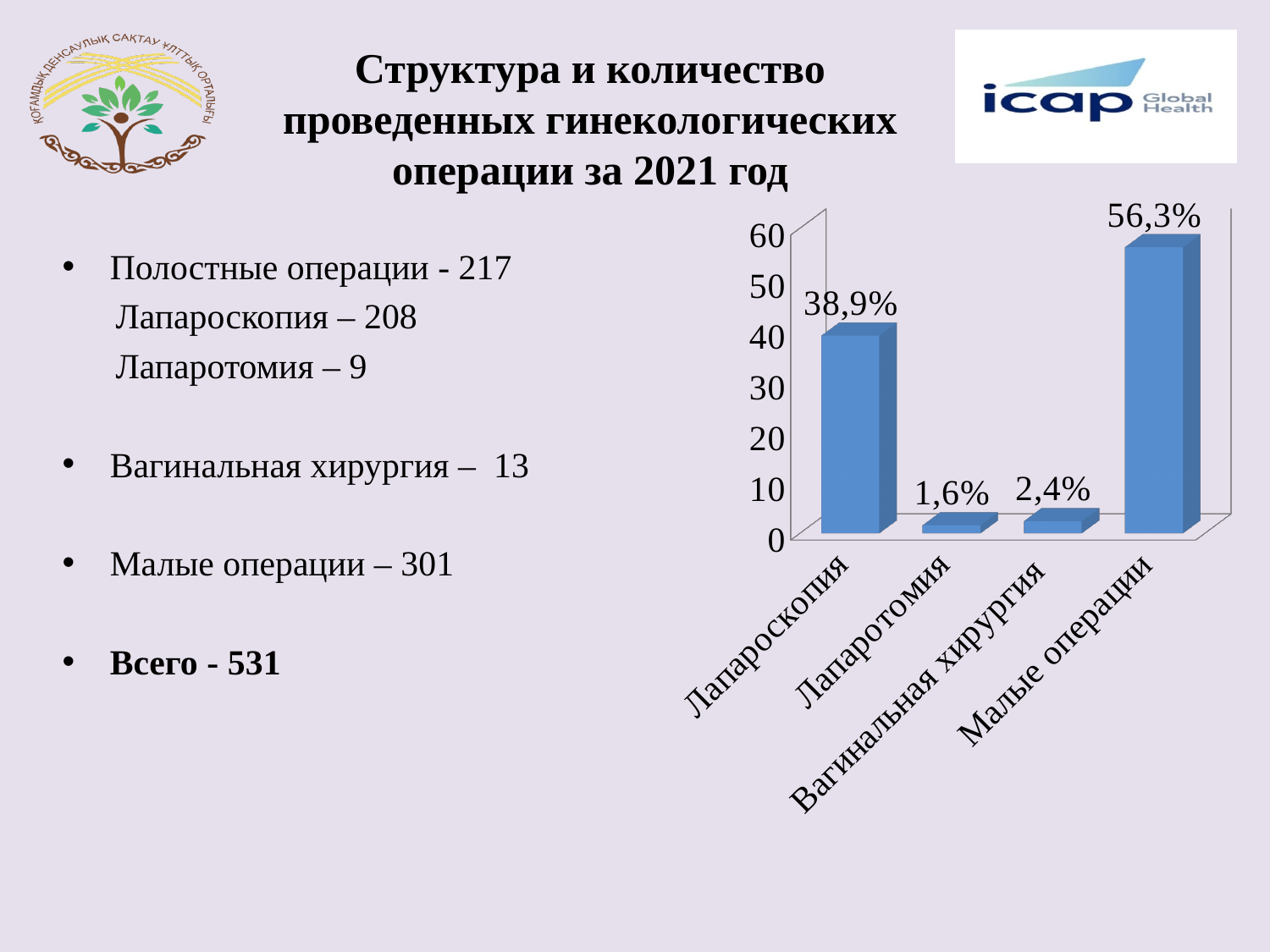
Which category has the highest value? Малые операции What is the value shown for Вагинальная хирургия? 2,4% What is the highest value shown on the vertical axis? 60 Which is larger, the value for Вагинальная хирургия or the value for Лапаротомия? Вагинальная хирургия Is the value for Лапароскопия greater or less than 30? greater What kind of chart is shown on the slide? bar chart Which category has the lowest value? Лапаротомия What is the value shown for Лапароскопия? 38,9% What is the difference between the values for Малые операции and Лапароскопия? 17,4% What is the value shown for Лапаротомия? 1,6% How many categories are shown on the chart? 4 What is the value shown for Малые операции? 56,3%